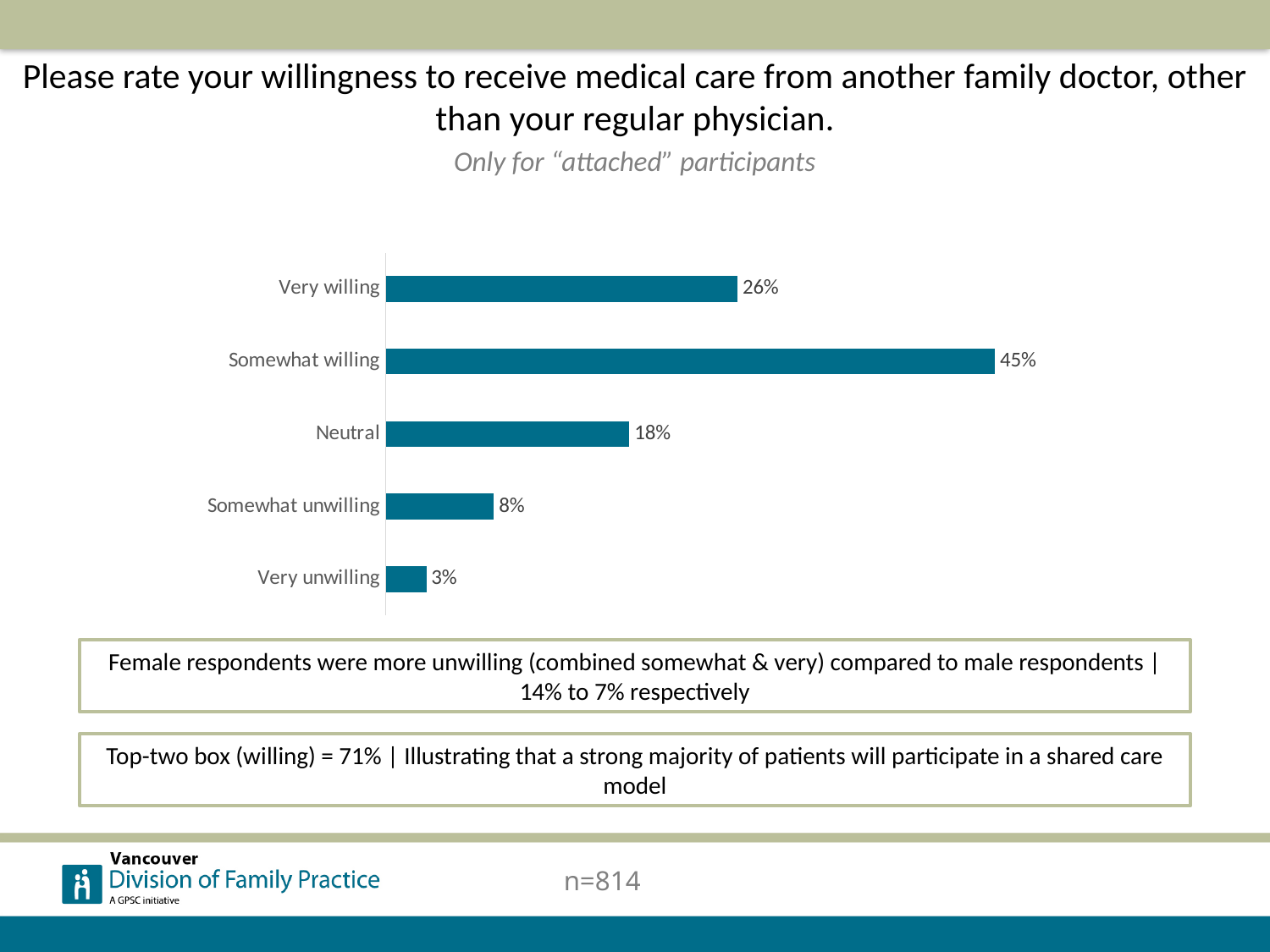
What percentage of respondents were 'Neutral'? 18% What kind of chart is shown on the slide? Bar chart Which category has the highest percentage? Somewhat willing Which is larger, the value for 'Neutral' or the value for 'Somewhat unwilling'? Neutral How many categories are shown in the chart? 5 Which category has the lowest percentage? Very unwilling What percentage of respondents were 'Somewhat willing'? 45% What is the combined percentage of 'Very willing' and 'Somewhat willing' respondents? 71% What is the difference in percentage points between 'Somewhat willing' and 'Very willing'? 19 What percentage of respondents were 'Very willing'? 26% What percentage of respondents were 'Somewhat unwilling'? 8% What percentage of respondents were 'Very unwilling'? 3%